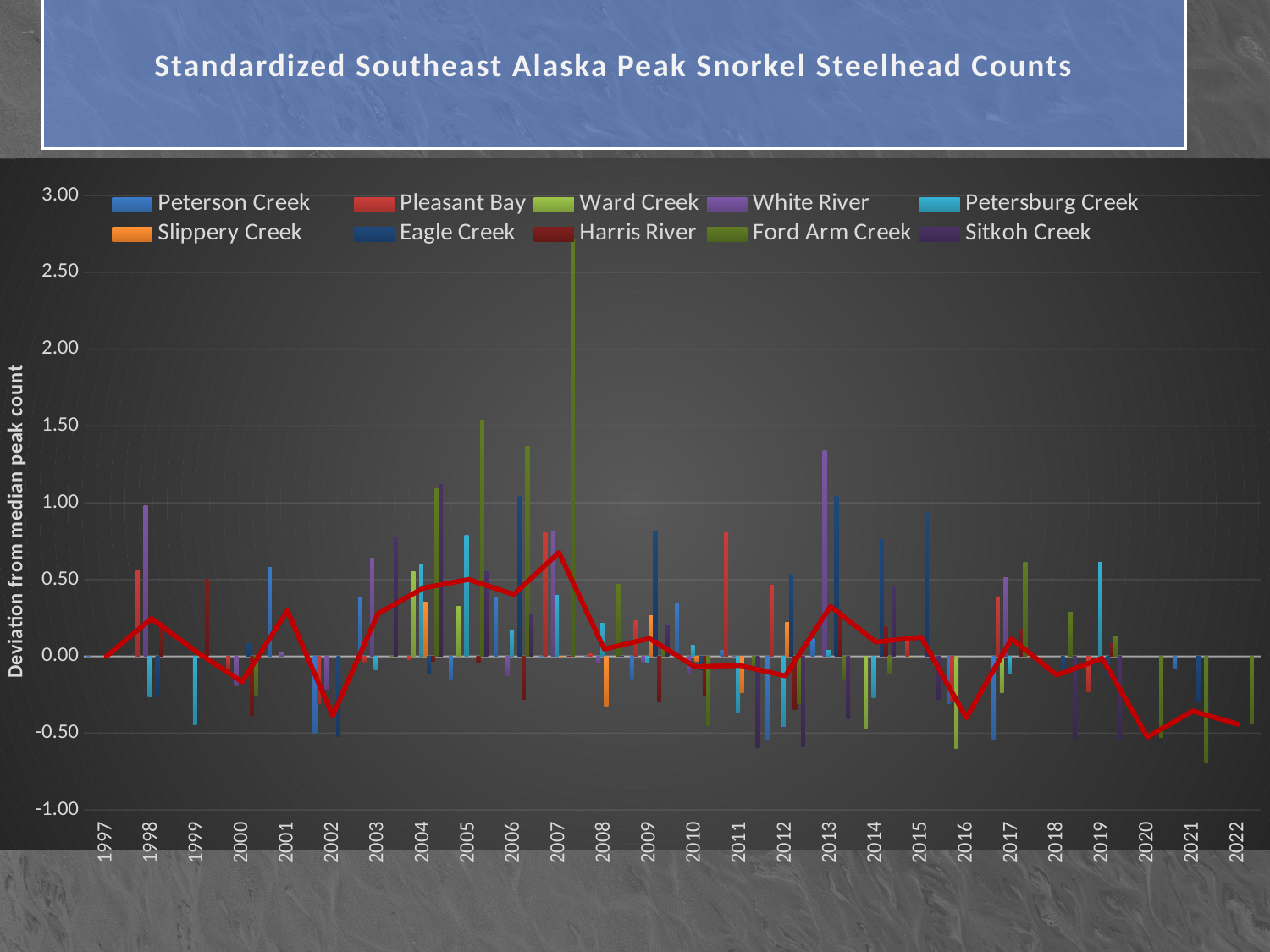
What is the title of the chart? Standardized Southeast Alaska Peak Snorkel Steelhead Counts Is the value for White River in 2013 greater or less than 1.00? greater How many series does the legend list? 10 What kind of chart is shown on the slide? combination bar and line chart Is the value for Ford Arm Creek in 2007 greater or less than 2.50? greater Is the red line's value higher in 2007 or in 2022? 2007 What is the label on the vertical axis of the chart? Deviation from median peak count Is the value for Ford Arm Creek in 2021 greater or less than -0.50? less In which year does the tallest bar on the chart appear? 2007 How many years are shown along the x axis? 26